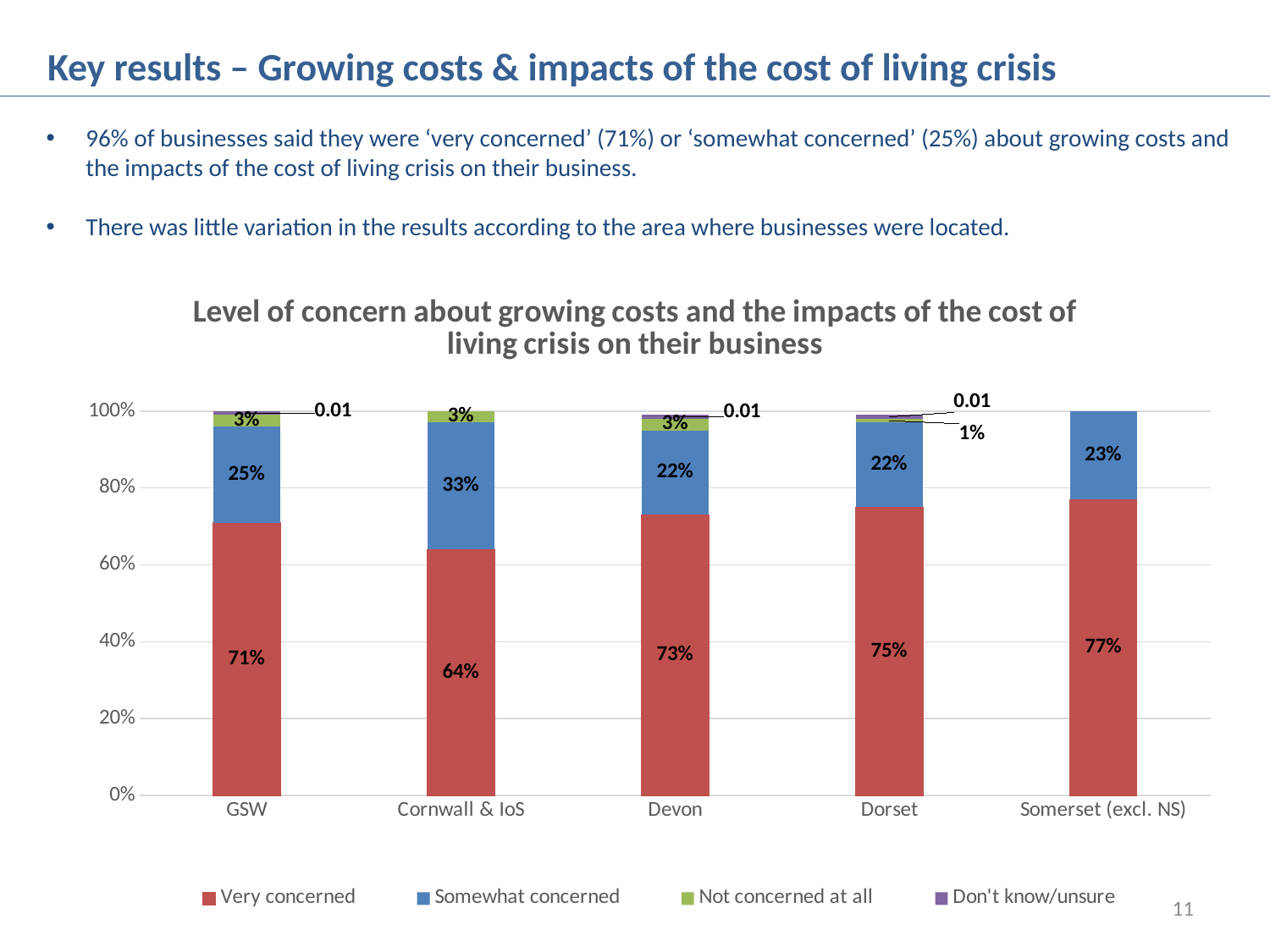
How many areas are shown on the x axis? 5 What kind of chart is shown on the slide? Stacked bar chart What percentage of businesses in Cornwall & IoS were 'Very concerned'? 64% Which area has the lowest 'Very concerned' percentage? Cornwall & IoS What is the difference between the 'Very concerned' percentages for Somerset (excl. NS) and Cornwall & IoS? 13% Which area has the highest 'Somewhat concerned' percentage? Cornwall & IoS Is the 'Very concerned' value for Cornwall & IoS greater or less than 60%? greater What percentage of businesses in Somerset (excl. NS) were 'Somewhat concerned'? 23% How many series does the legend list? 4 Which area has the highest 'Very concerned' percentage? Somerset (excl. NS) Which is larger: the 'Very concerned' percentage for Devon or for GSW? Devon What is the 'Not concerned at all' value for Dorset? 1%